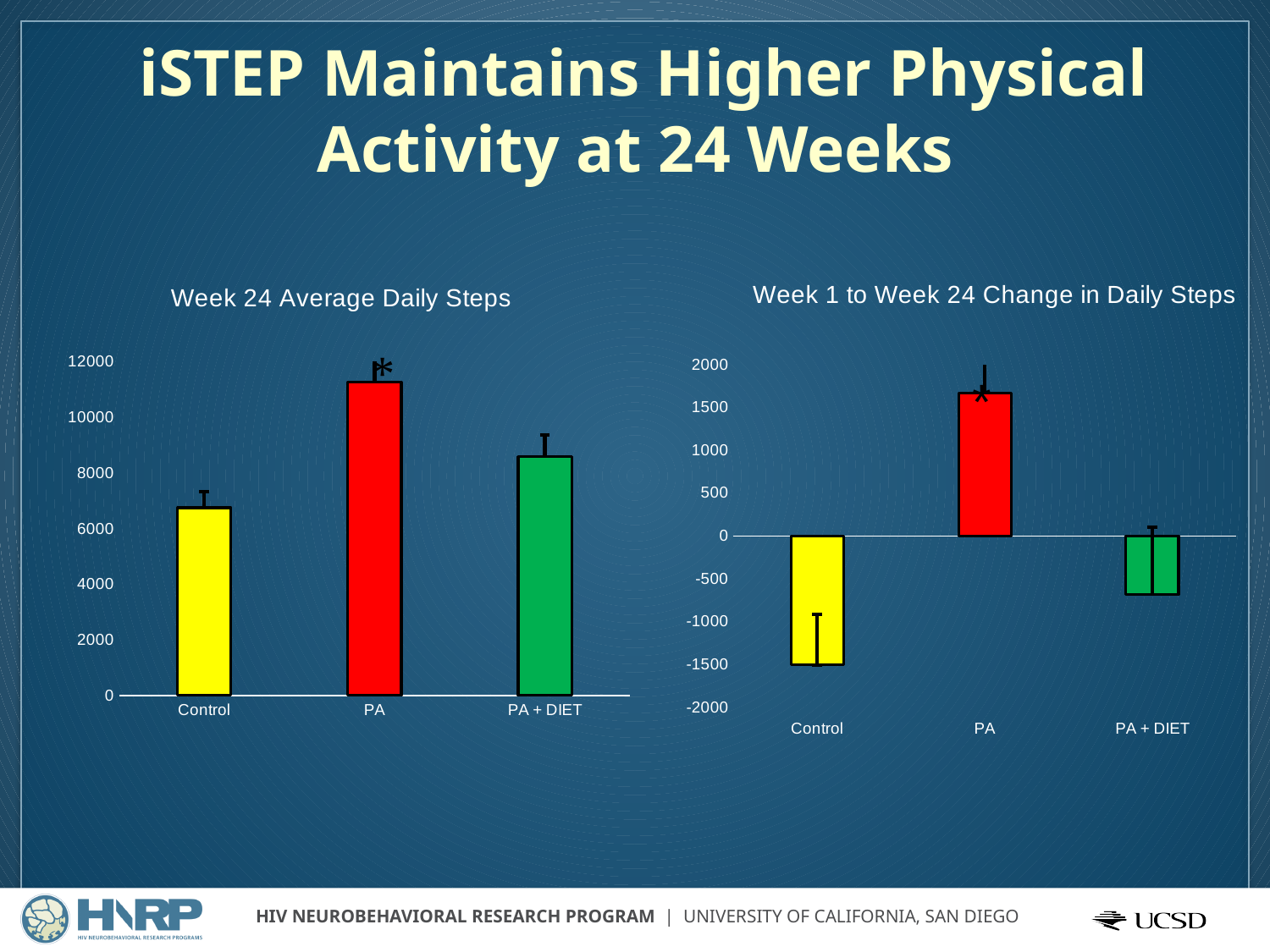
In the 'Week 24 Average Daily Steps' chart, is the value for PA greater or less than 10000? greater In the 'Week 1 to Week 24 Change in Daily Steps' chart, which group has the highest change in daily steps? PA In the 'Week 24 Average Daily Steps' chart, which group has the highest average daily steps? PA In the 'Week 24 Average Daily Steps' chart, how many groups are shown on the x axis? 3 In the 'Week 24 Average Daily Steps' chart, what colour is the bar for PA + DIET? green What kind of chart is the 'Week 1 to Week 24 Change in Daily Steps' chart? bar chart In the 'Week 24 Average Daily Steps' chart, is the value for PA + DIET greater or less than 8000? greater In the 'Week 1 to Week 24 Change in Daily Steps' chart, which group has the lowest change in daily steps? Control In the 'Week 24 Average Daily Steps' chart, which group has the lowest average daily steps? Control In the 'Week 1 to Week 24 Change in Daily Steps' chart, is the value for Control greater or less than -1000? less